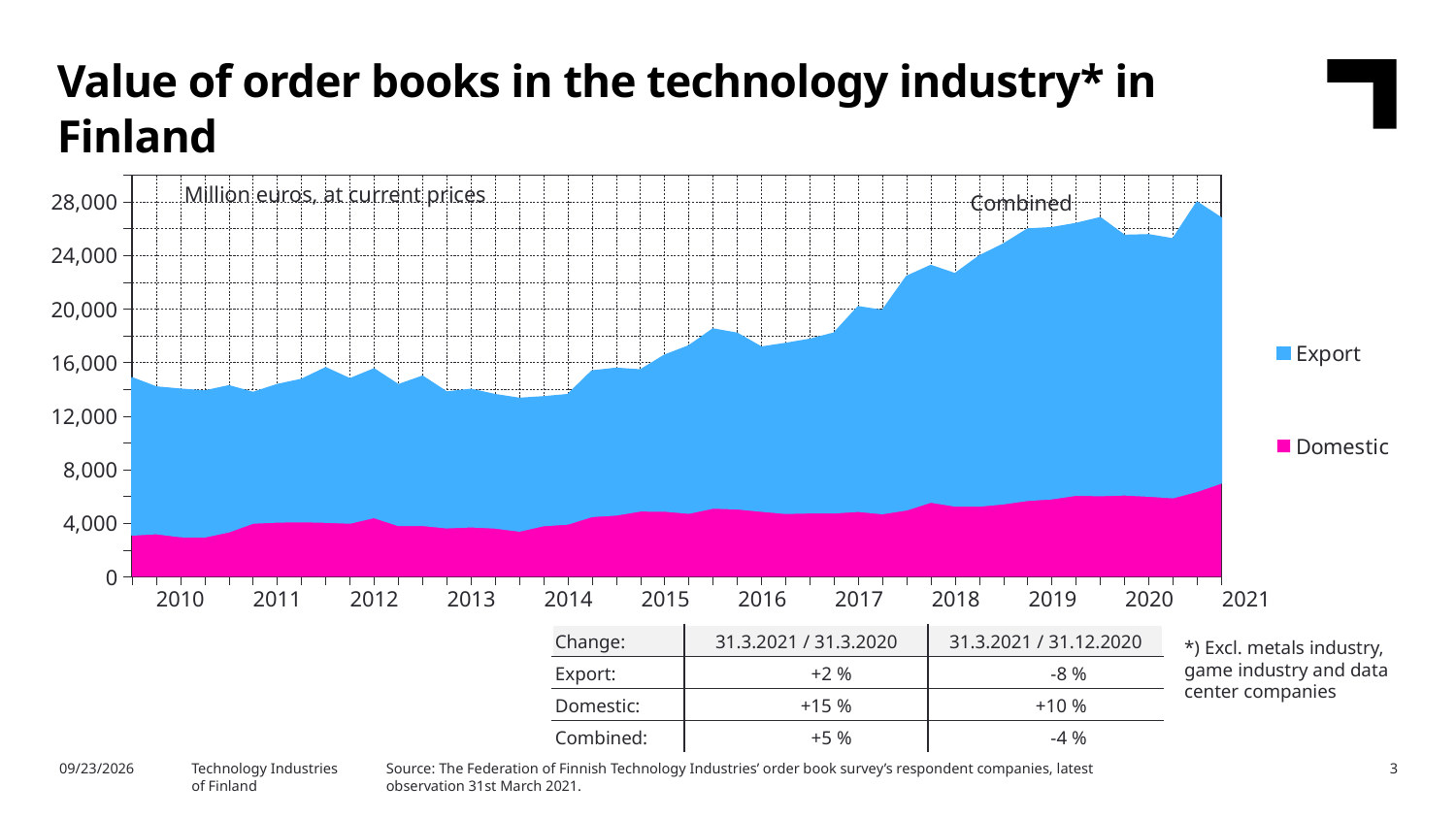
Is the Combined value at the end of the series in 2021 greater or less than 24,000? greater What kind of chart is shown on the slide? stacked area chart Which two series are listed in the chart legend? Export and Domestic Does the Combined value of order books generally rise or fall from 2010 to 2021? rise Is the Domestic value at the end of the series in 2021 greater or less than 4,000? greater Is the Combined value in 2018 greater or less than 20,000? greater How many series does the chart legend list? 2 Which series is larger throughout the chart, Export or Domestic? Export How many year labels are shown along the x axis of the chart? 12 What unit is stated for the values in the chart? Million euros, at current prices